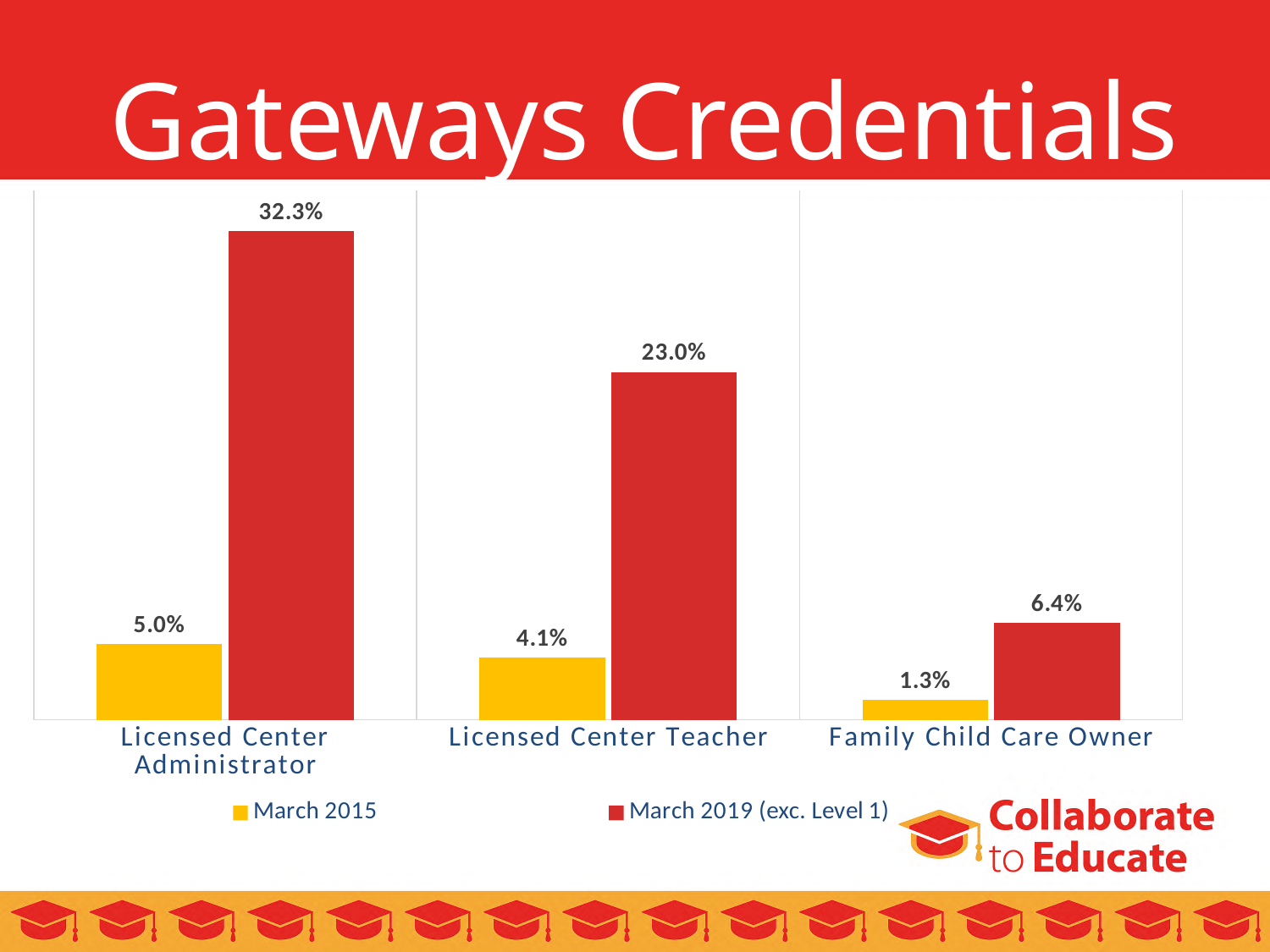
What is the March 2015 value for Licensed Center Teacher? 4.1% What is the March 2019 (exc. Level 1) value for Licensed Center Administrator? 32.3% What is the difference between the March 2019 (exc. Level 1) values for Licensed Center Administrator and Licensed Center Teacher? 9.3% Which category has the lowest March 2015 value? Family Child Care Owner How many categories are shown on the x axis? 3 How many series does the legend list? 2 What is the March 2019 (exc. Level 1) value for Family Child Care Owner? 6.4% Which category has the highest March 2019 (exc. Level 1) value? Licensed Center Administrator What is the March 2015 value for Family Child Care Owner? 1.3% What kind of chart is shown on the slide? Bar chart What is the difference between the March 2019 (exc. Level 1) and March 2015 values for Licensed Center Administrator? 27.3% Which is larger: the March 2015 value for Licensed Center Administrator or the March 2015 value for Licensed Center Teacher? Licensed Center Administrator